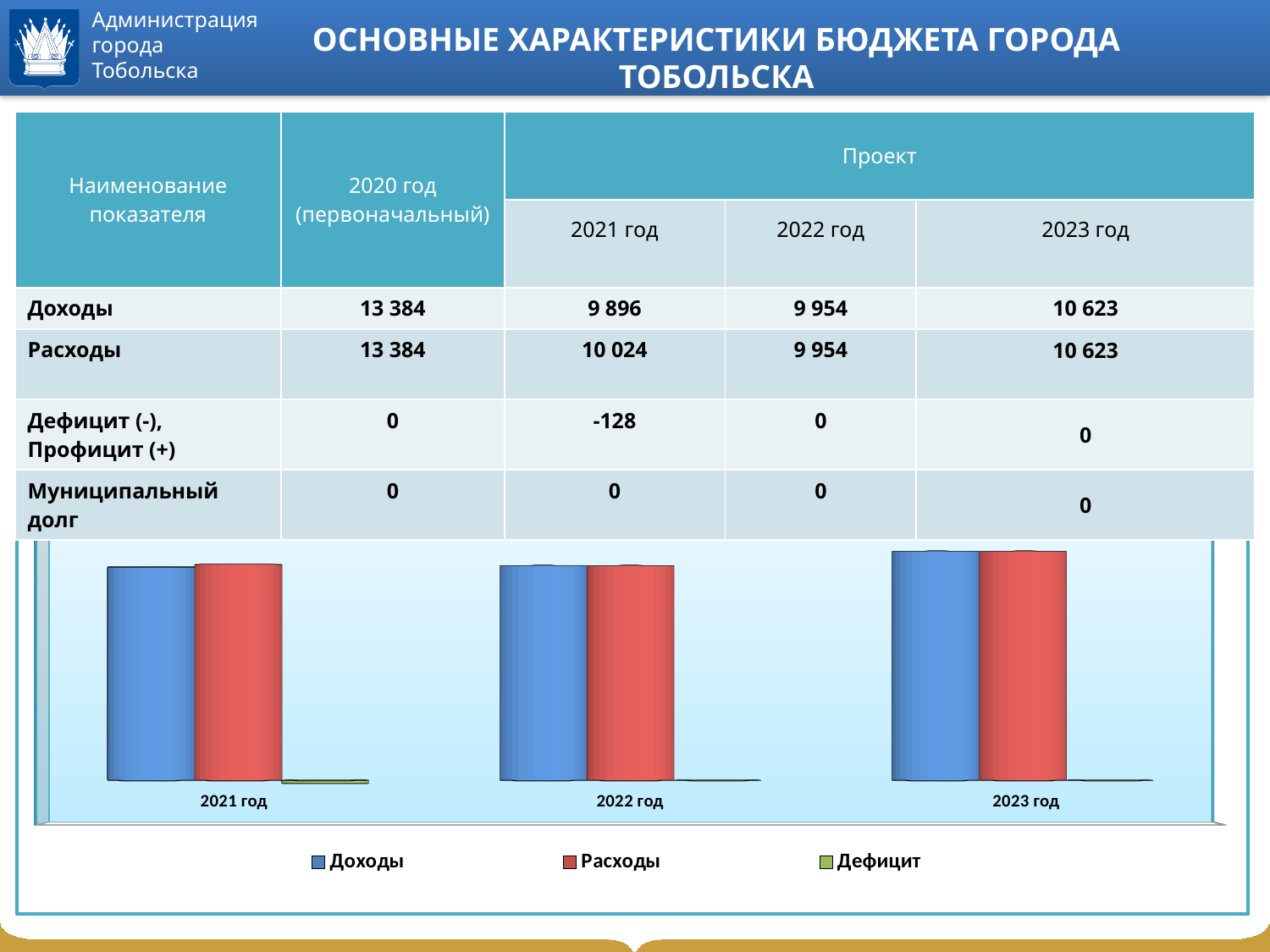
According to the slide, what is the Доходы value for 2021 год? 9 896 Which is larger in 2021 год: the Доходы bar or the Расходы bar? Расходы How many year categories are shown on the chart's x axis? 3 Which series is shown in green in the chart legend? Дефицит How many series does the chart legend list? 3 In which year is the Доходы bar the tallest? 2023 год What kind of chart is shown at the bottom of the slide? bar chart In which year is the Расходы bar the tallest? 2023 год Do the Расходы bars rise or fall from 2021 год to 2023 год? rise According to the slide, what is the Дефицит value for 2021 год? -128 Which is larger: the Доходы bar for 2023 год or the Доходы bar for 2021 год? 2023 год Which series is shown in blue in the chart legend? Доходы